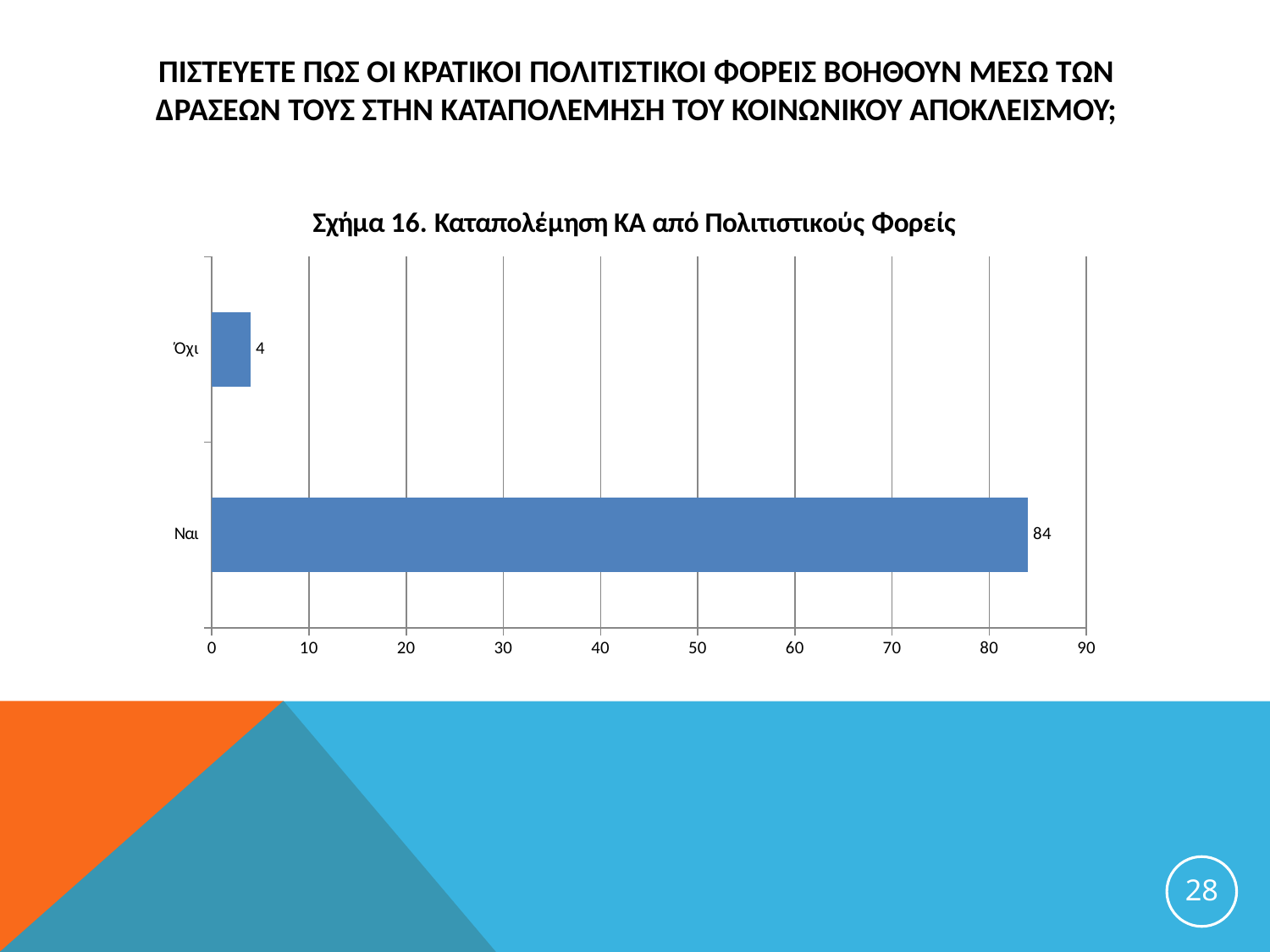
Is the value for Όχι greater or less than 10? less Which is larger, the value for Ναι or the value for Όχι? Ναι What is the maximum value shown on the horizontal axis? 90 Which category has the lowest value? Όχι How many categories are shown in the chart? 2 What kind of chart is shown on the slide? bar chart What is the value for Ναι? 84 What is the title of the chart? Σχήμα 16. Καταπολέμηση ΚΑ από Πολιτιστικούς Φορείς What is the value for Όχι? 4 Which category has the highest value? Ναι What is the difference between the values for Ναι and Όχι? 80 Is the value for Ναι greater or less than 80? greater